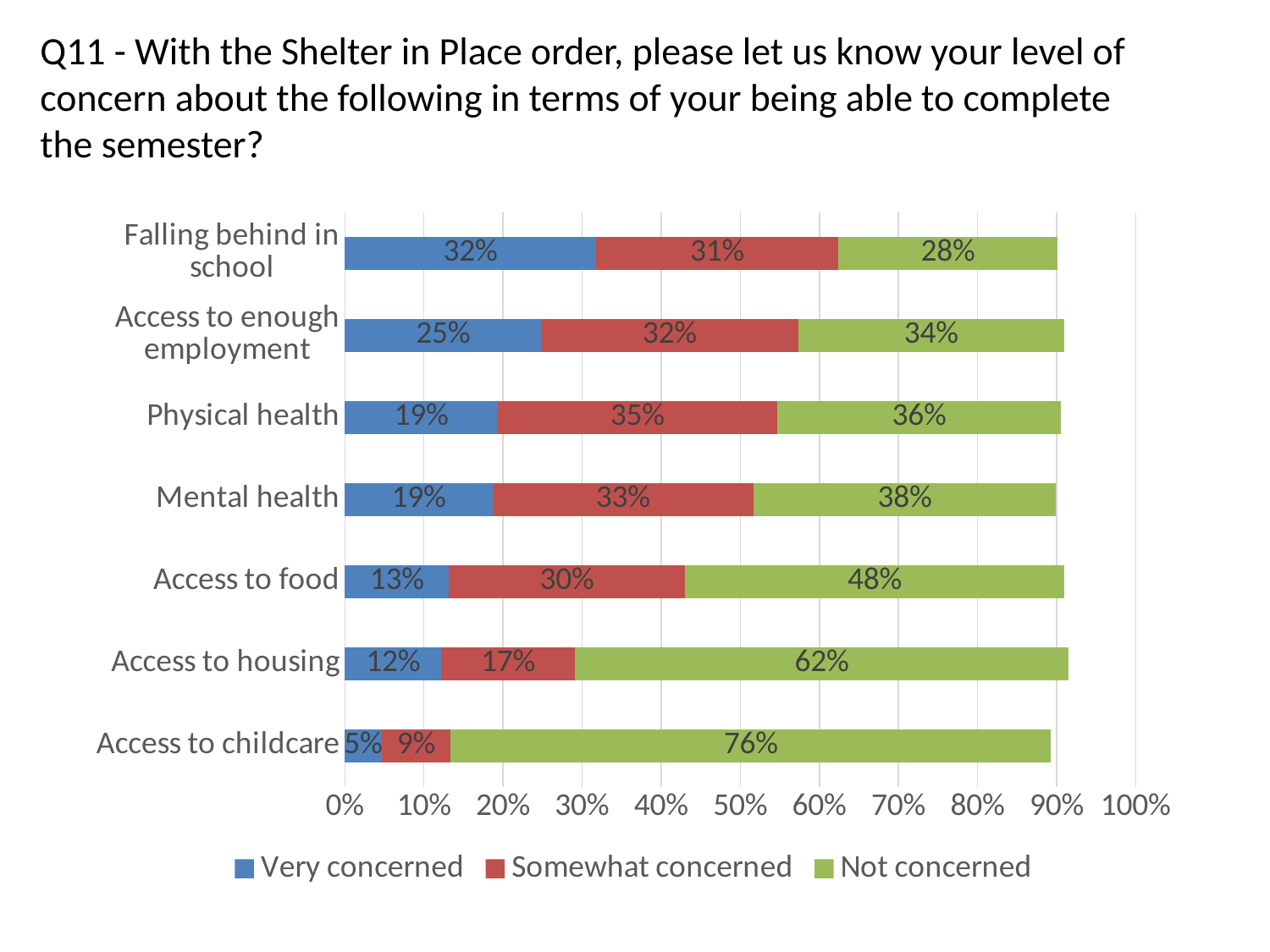
Which category has the highest 'Not concerned' value? Access to childcare How many categories are plotted on the chart? 7 What is the 'Very concerned' value for Falling behind in school? 32% What is the 'Not concerned' value for Access to childcare? 76% What is the difference between the 'Not concerned' values for Access to housing and Access to food? 14 percentage points What is the 'Somewhat concerned' value for Physical health? 35% Which category has the lowest 'Very concerned' value? Access to childcare How many series does the legend list? 3 Which is larger: the 'Very concerned' value for Access to enough employment or for Access to food? Access to enough employment What is the total of the stacked bar for Falling behind in school? 91% What kind of chart is shown on the slide? Stacked bar chart Which series is shown in green in the legend? Not concerned